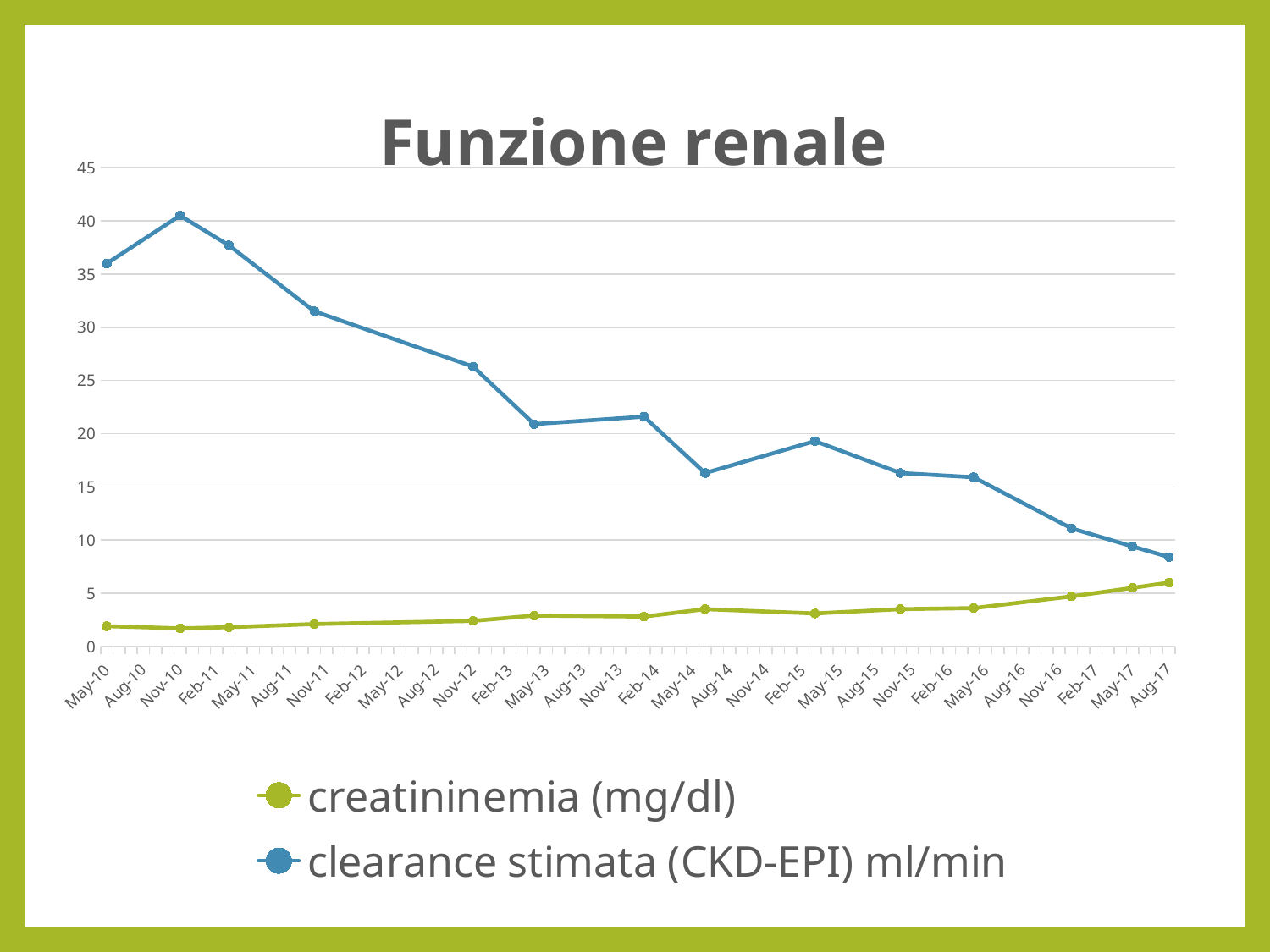
Which series is drawn in blue? clearance stimata (CKD-EPI) ml/min Is the clearance stimata (CKD-EPI) value at Nov-10 greater or less than 35? greater How many series does the legend list? 2 What is the title of the chart? Funzione renale At which date is the clearance stimata (CKD-EPI) value highest? Nov-10 What kind of chart is shown on the slide? line chart Does the clearance stimata (CKD-EPI) series rise or fall overall from May-10 to Aug-17? fall Is the creatininemia (mg/dl) value at Aug-17 greater or less than 5? greater Does the creatininemia (mg/dl) series rise or fall overall from May-10 to Aug-17? rise Is the clearance stimata (CKD-EPI) value at Aug-17 greater or less than 10? less At which date is the clearance stimata (CKD-EPI) value lowest? Aug-17 At May-10, which series has the larger value, creatininemia (mg/dl) or clearance stimata (CKD-EPI) ml/min? clearance stimata (CKD-EPI) ml/min